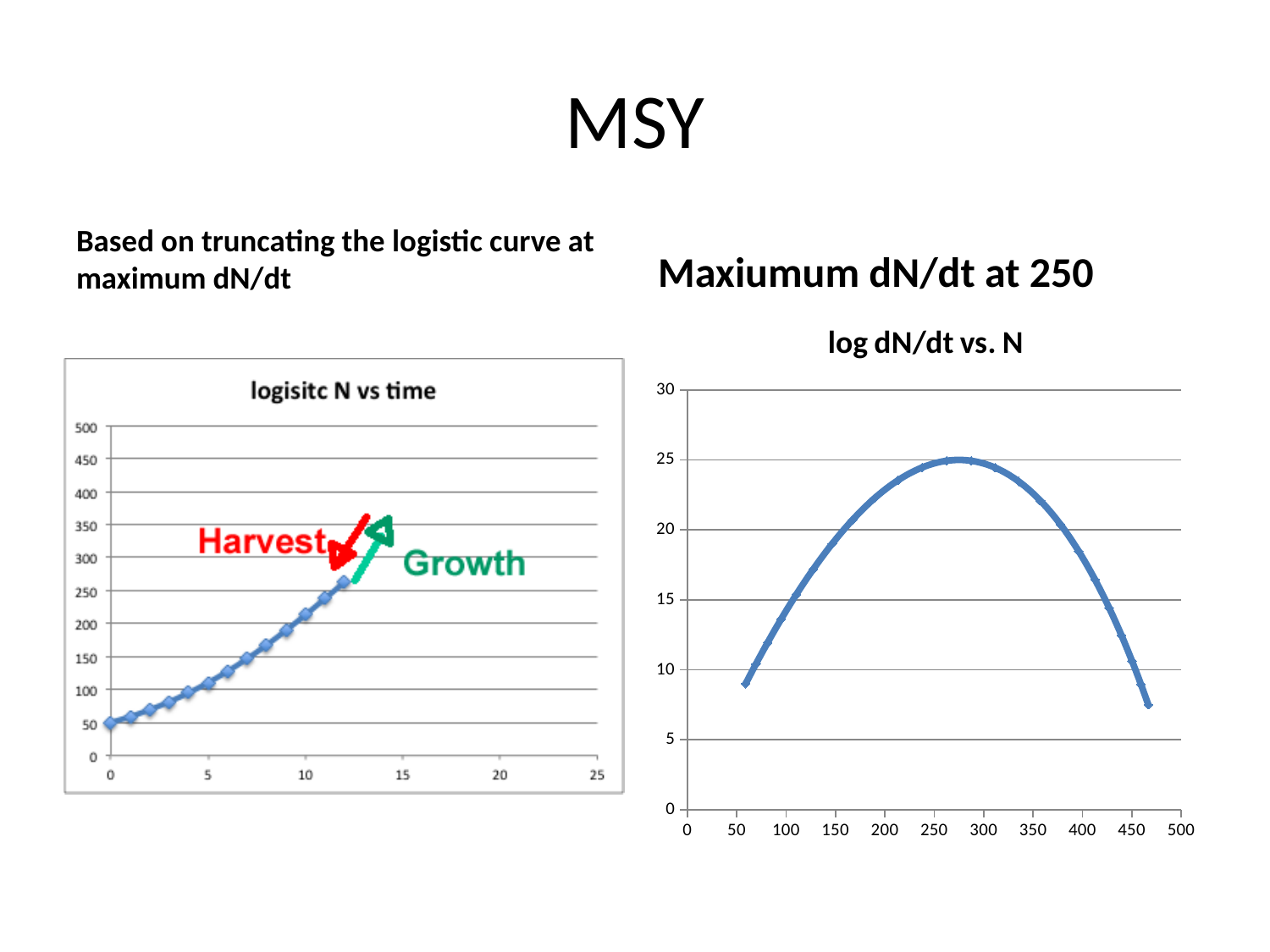
In the 'log dN/dt vs. N' chart, is the peak value of the curve greater or less than 20? greater What two labels are written next to the arrows on the 'logisitc N vs time' chart? Harvest and Growth In the 'logisitc N vs time' chart, is the value at time 10 greater or less than 150? greater In the 'log dN/dt vs. N' chart, how do the values change as N increases from 50 to 450? rise then fall How many data points are plotted in the 'logisitc N vs time' chart? 13 What kind of chart is the 'log dN/dt vs. N' chart on the right? line chart In the 'log dN/dt vs. N' chart, is the value at N = 100 greater or less than 10? greater What kind of chart is the 'logisitc N vs time' chart on the left? line chart In the 'logisitc N vs time' chart, do the values rise or fall as time increases? rise